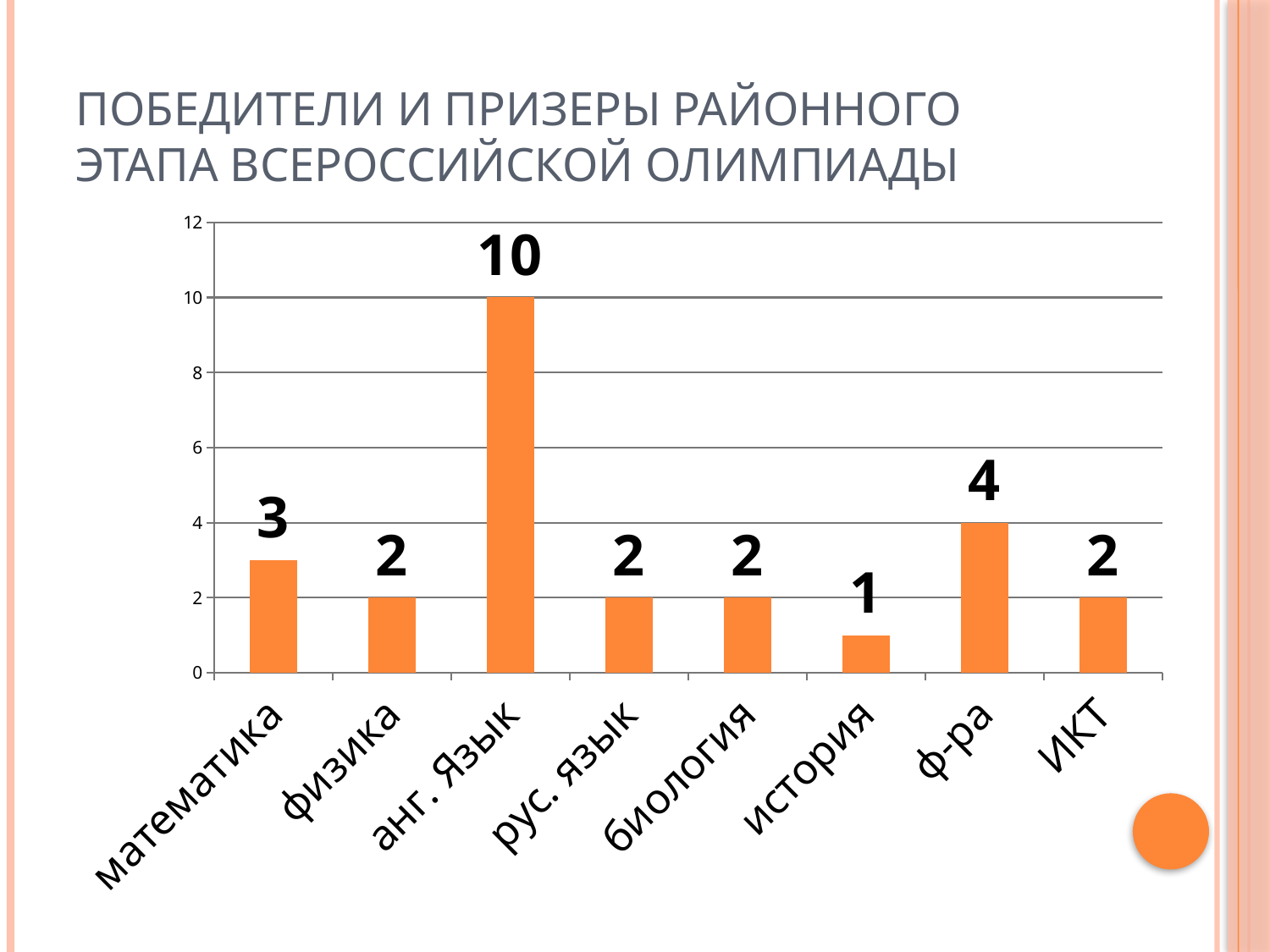
Which category has the lowest value? история What is the value for история? 1 Which is larger, the value for математика or the value for физика? математика What is the difference between the values for анг. Язык and ф-ра? 6 What colour are the bars in the chart? orange Is the value for анг. Язык greater or less than 8? greater What is the value for анг. Язык? 10 What is the value for ф-ра? 4 What kind of chart is shown on the slide? bar chart How many categories are shown on the x axis? 8 Which category has the highest value? анг. Язык What is the value for математика? 3